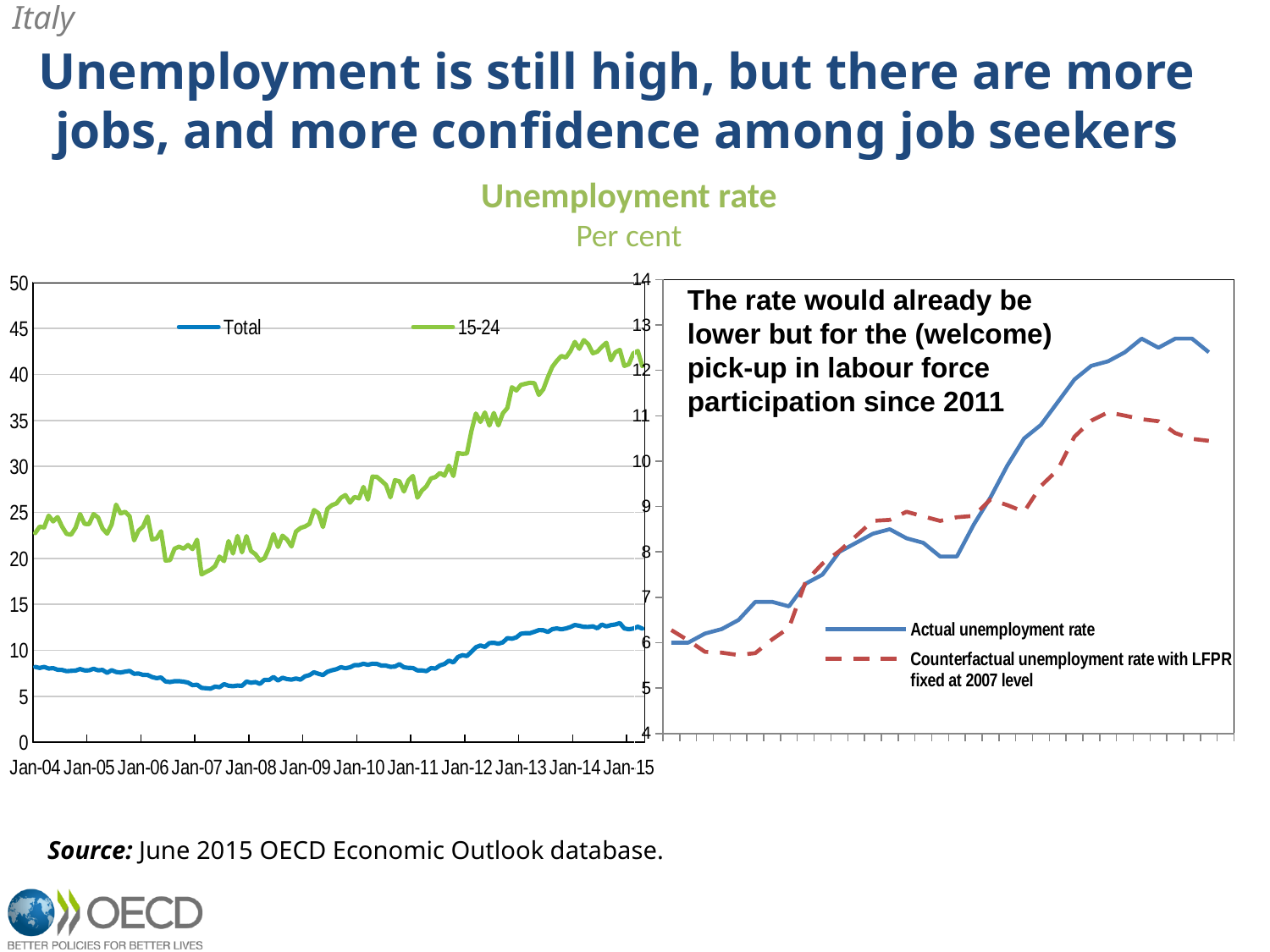
In the right chart, which series is higher at the right end of the chart, the Actual unemployment rate or the Counterfactual unemployment rate with LFPR fixed at 2007 level? Actual unemployment rate What kind of chart is the left chart titled 'Unemployment rate'? line chart In the left chart titled 'Unemployment rate', does the 15-24 series rise or fall between Jan-09 and Jan-14? rise In the left chart titled 'Unemployment rate', which series is higher throughout the period, Total or 15-24? 15-24 In the right chart, is the value of the Actual unemployment rate at the right end of the chart greater or less than 12? greater In the left chart titled 'Unemployment rate', is the value for Total at Jan-15 greater or less than 10? greater In the left chart titled 'Unemployment rate', does the Total series rise or fall between Jan-04 and Jan-07? fall In the left chart titled 'Unemployment rate', is the peak value of the 15-24 series greater or less than 40? greater How many series does the legend of the right chart list? 2 How many series does the legend of the left chart titled 'Unemployment rate' list? 2